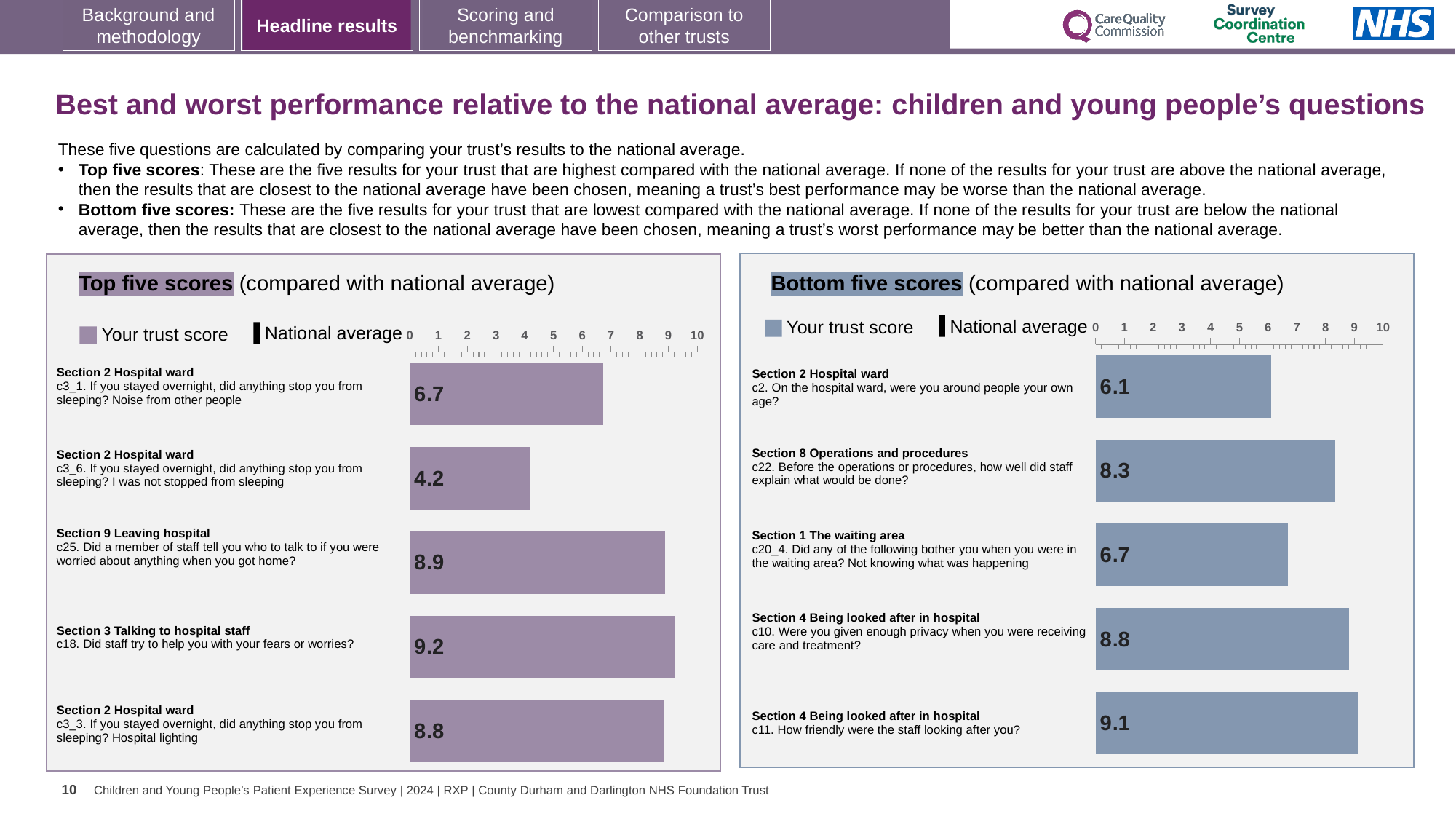
In the Top five scores chart, what is the trust score for c18 'Did staff try to help you with your fears or worries?' 9.2 In the Top five scores chart, which question has the highest trust score? c18. Did staff try to help you with your fears or worries? What kind of chart is the Bottom five scores chart? Bar chart In the Bottom five scores chart, which has the larger trust score: c10 (enough privacy) or c20_4 (not knowing what was happening)? c10 In the Top five scores chart, is the trust score for c3_1 (noise from other people) greater or less than 5? greater What two entries does the legend of the Bottom five scores chart list? Your trust score and National average How many questions are plotted in the Top five scores chart? 5 In the Top five scores chart, what is the difference between the trust score for c25 and the trust score for c3_6? 4.7 In the Bottom five scores chart, which question has the lowest trust score? c2. On the hospital ward, were you around people your own age? In the Bottom five scores chart, what is the trust score for c22 'Before the operations or procedures, how well did staff explain what would be done?' 8.3 In the Bottom five scores chart, which question has the highest trust score? c11. How friendly were the staff looking after you? In the Top five scores chart, which question has the lowest trust score? c3_6. If you stayed overnight, did anything stop you from sleeping? I was not stopped from sleeping